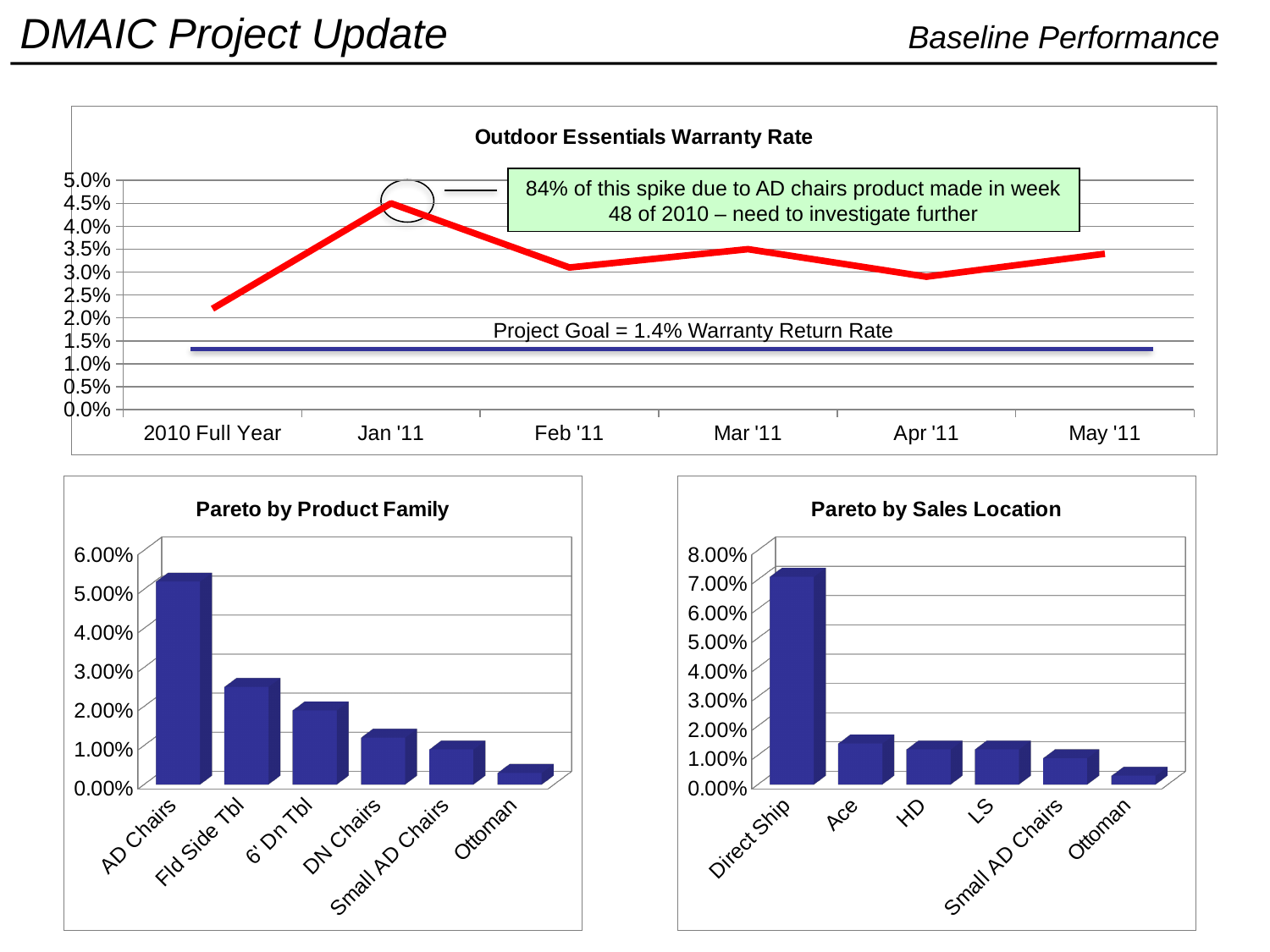
In the Outdoor Essentials Warranty Rate chart, which period has the lowest warranty rate? 2010 Full Year In the Outdoor Essentials Warranty Rate chart, which period has the highest warranty rate? Jan '11 In the Outdoor Essentials Warranty Rate chart, is the value for 2010 Full Year greater or less than 2.5%? less In the Pareto by Sales Location chart, is the value for Direct Ship greater or less than 6.00%? greater In the Pareto by Product Family chart, which product family has the highest value? AD Chairs In the Pareto by Product Family chart, which product family has the lowest value? Ottoman In the Pareto by Product Family chart, which is larger, Fld Side Tbl or 6' Dn Tbl? Fld Side Tbl In the Outdoor Essentials Warranty Rate chart, is the value for Jan '11 greater or less than 4.0%? greater How many periods are shown on the x axis of the Outdoor Essentials Warranty Rate chart? 6 What kind of chart is the Pareto by Sales Location chart? Bar chart What kind of chart is the Outdoor Essentials Warranty Rate chart? Line chart According to the Outdoor Essentials Warranty Rate chart, what is the project goal warranty return rate? 1.4%